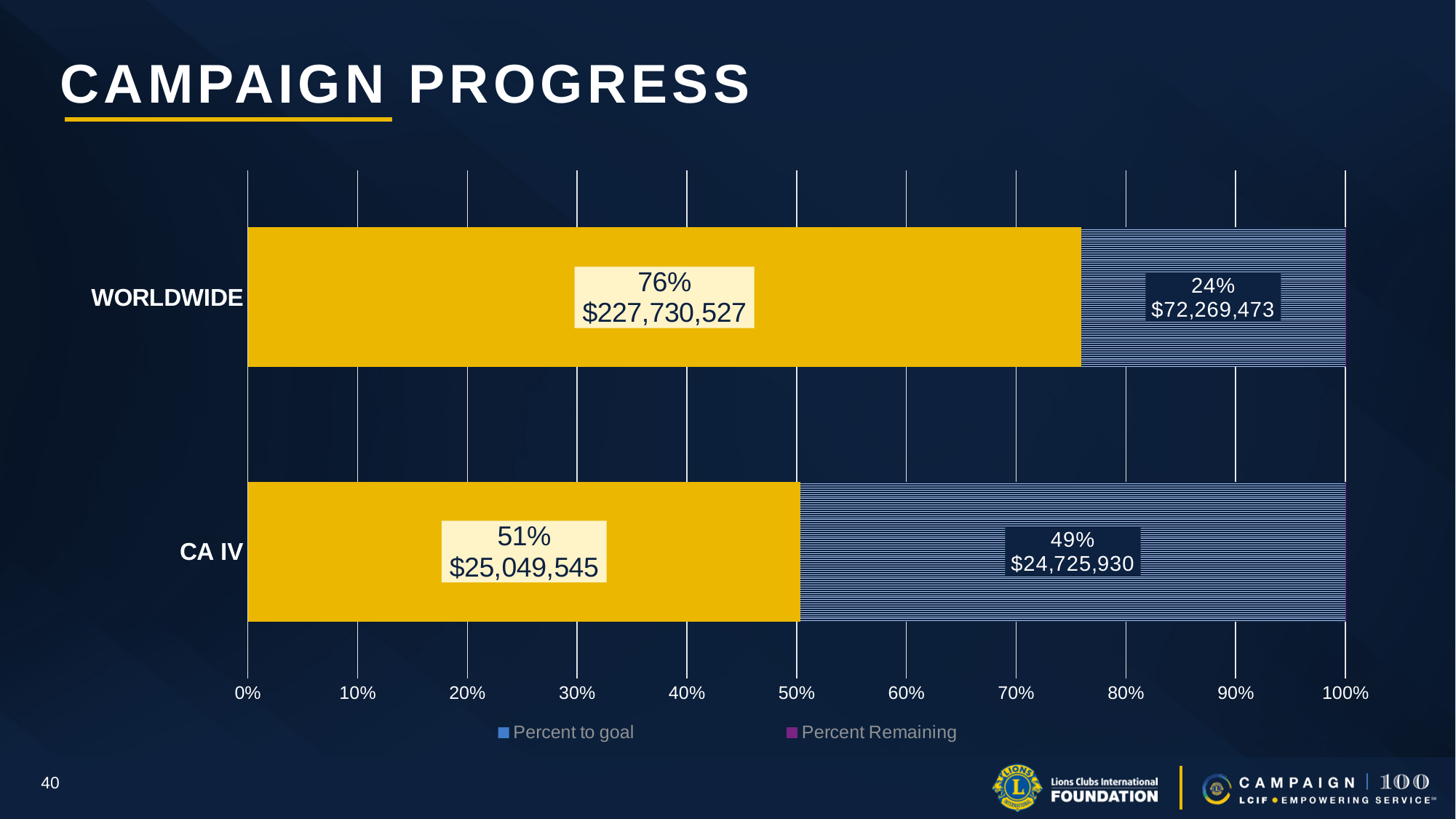
What type of chart is shown on the slide? Stacked bar chart Which category has the higher Percent to goal? WORLDWIDE What dollar amount is shown for the Percent to goal segment of WORLDWIDE? $227,730,527 Which category has the lower Percent Remaining? WORLDWIDE Is the Percent to goal for CA IV greater or less than the Percent Remaining for CA IV? greater What is the difference in Percent to goal between WORLDWIDE and CA IV? 25% What dollar amount is shown for the Percent Remaining segment of CA IV? $24,725,930 What is the Percent to goal value for WORLDWIDE? 76% Is the Percent to goal for WORLDWIDE greater or less than 70%? greater What is the Percent Remaining value for CA IV? 49% How many series does the legend list? 2 How many categories are shown on the chart? 2